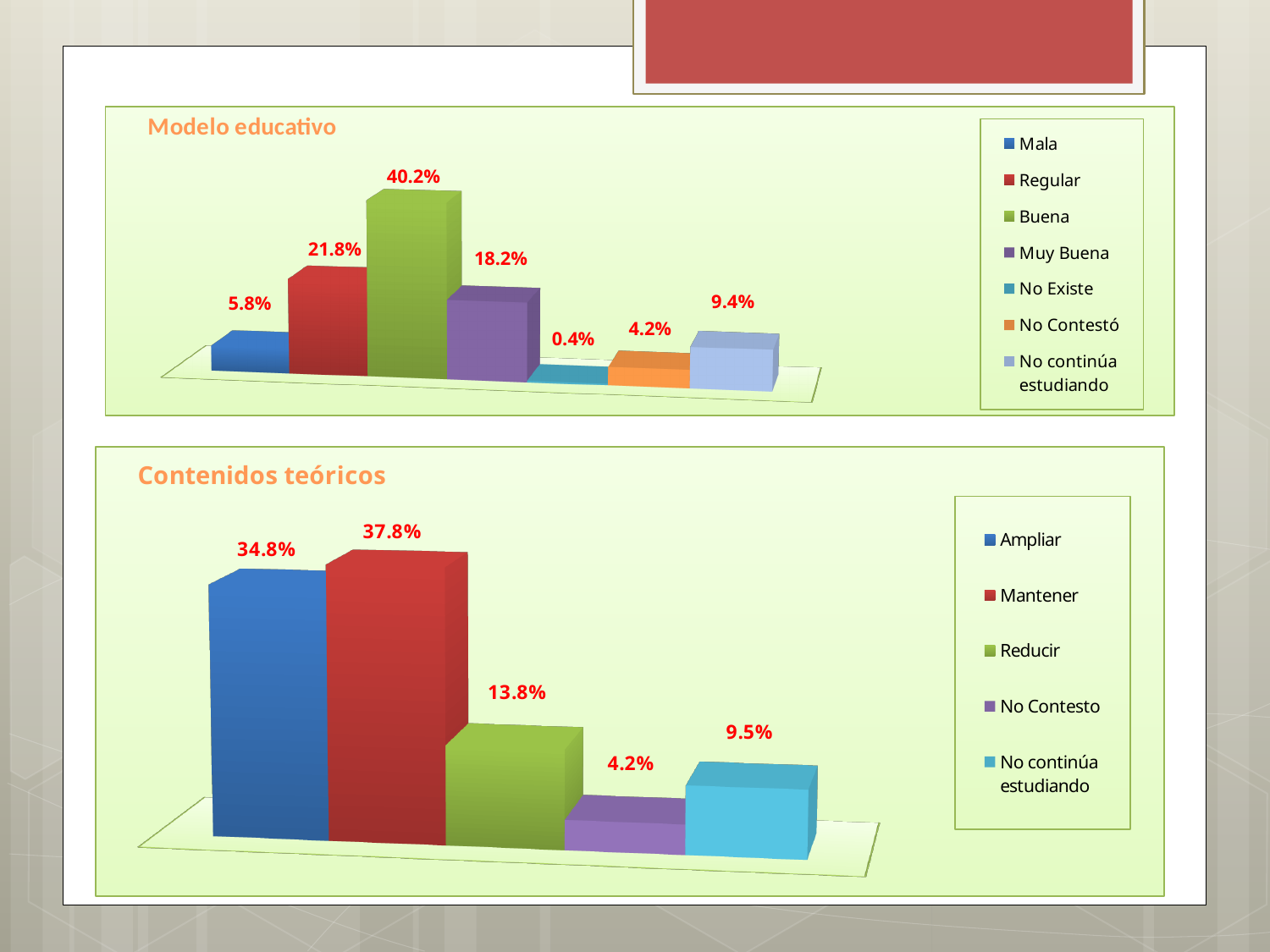
In the 'Modelo educativo' chart, which category has the lowest value? No Existe In the 'Modelo educativo' chart, what is the difference between Buena and Muy Buena? 22.0% In the 'Modelo educativo' chart, what is the value for Regular? 21.8% In the 'Contenidos teóricos' chart, what colour is the bar for Reducir? Green In the 'Contenidos teóricos' chart, which is larger, Ampliar or Mantener? Mantener What type of chart is the 'Contenidos teóricos' chart? Bar chart In the 'Contenidos teóricos' chart, what is the value for Mantener? 37.8% In the 'Contenidos teóricos' chart, how many entries does the legend list? 5 In the 'Modelo educativo' chart, how many bars are plotted? 7 In the 'Modelo educativo' chart, what is the value for Buena? 40.2% In the 'Modelo educativo' chart, which category has the highest value? Buena In the 'Contenidos teóricos' chart, what is the difference between Reducir and No Contesto? 9.6%